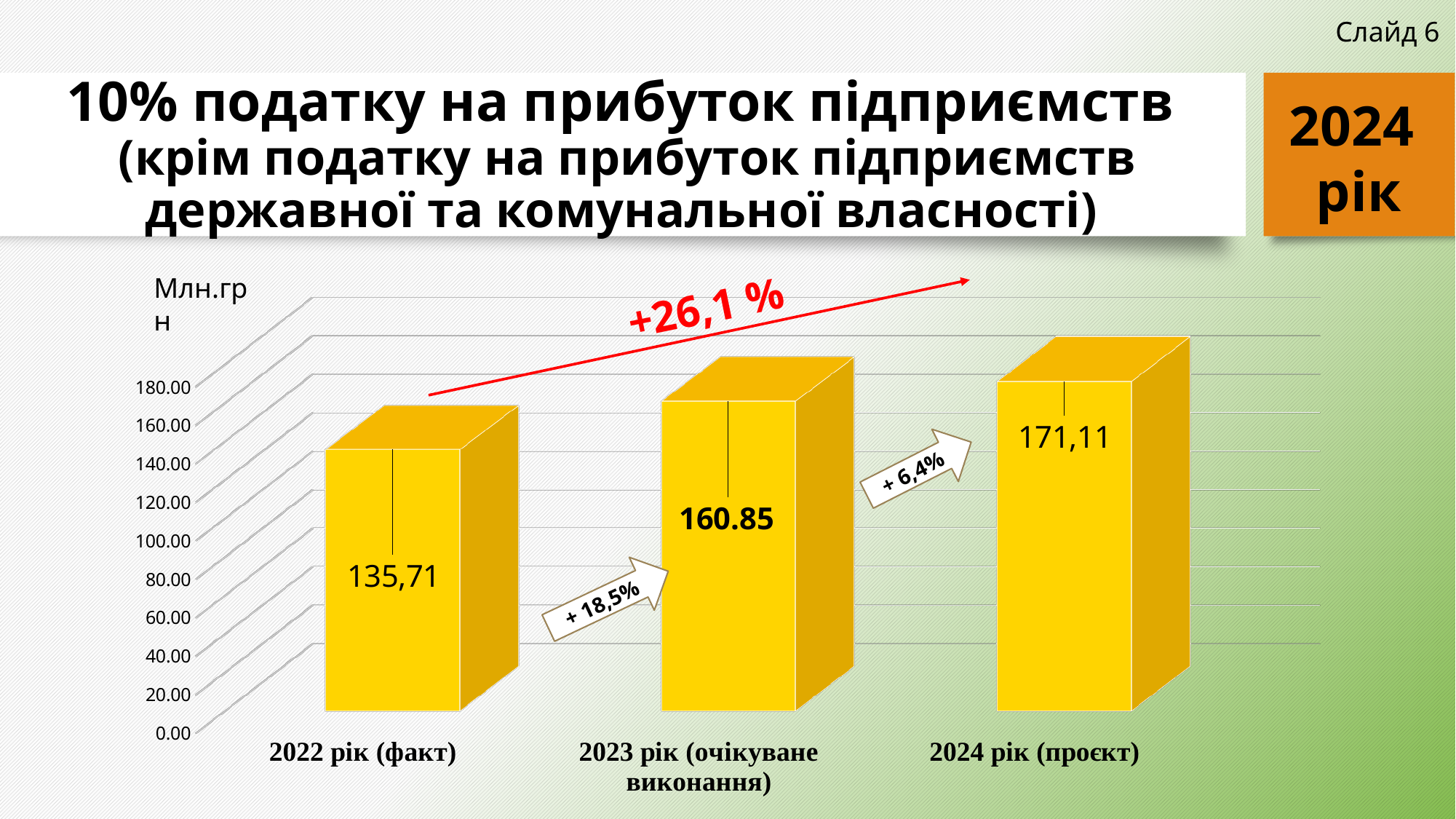
What is the value for 2024 рік (проєкт)? 171,11 What kind of chart is shown on the slide? bar chart What is the difference between the values for 2024 рік (проєкт) and 2022 рік (факт)? 35,40 What is the value for 2023 рік (очікуване виконання)? 160.85 How many bars are shown in the chart? 3 What is the value for 2022 рік (факт)? 135,71 Which category has the highest value? 2024 рік (проєкт) Is the value for 2022 рік (факт) greater or less than 140.00? less What is the difference between the values for 2023 рік (очікуване виконання) and 2022 рік (факт)? 25,14 Which is larger, the value for 2023 рік (очікуване виконання) or the value for 2024 рік (проєкт)? 2024 рік (проєкт) Which category has the lowest value? 2022 рік (факт) Do the values rise or fall from 2022 to 2024 along the x axis? rise